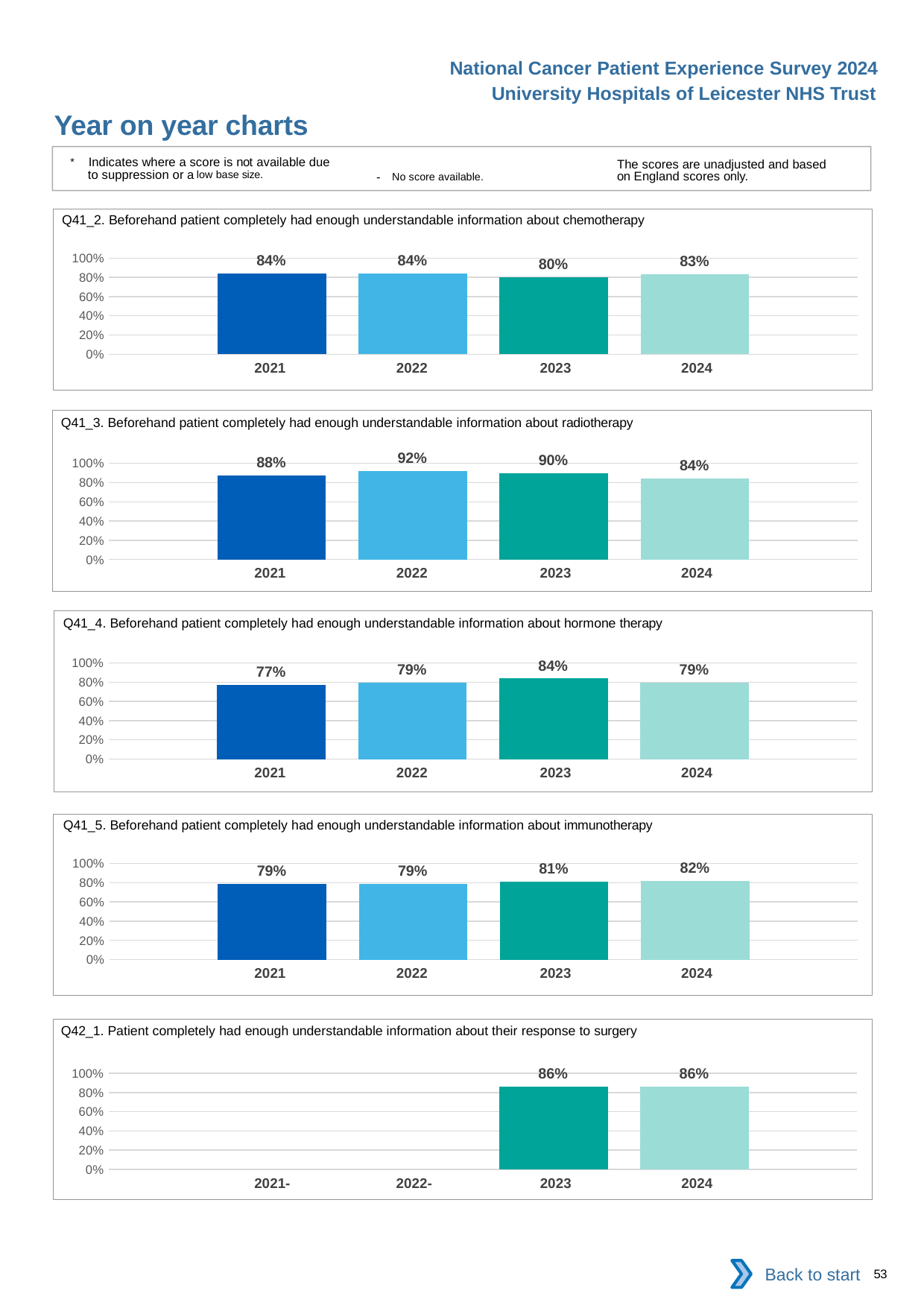
What kind of chart is the Q41_2 chart (chemotherapy)? bar chart In the Q41_4 chart (hormone therapy), which year has the lowest value? 2021 In the Q41_2 chart (chemotherapy), is the value for 2024 greater or less than 60%? greater In the Q42_1 chart (response to surgery), how many years have a bar plotted? 2 In the Q41_3 chart (radiotherapy), what is the difference between the 2022 and 2024 values? 8% In the Q41_4 chart (hormone therapy), what is the value for 2023? 84% In the Q41_5 chart (immunotherapy), is the value for 2023 or 2024 larger? 2024 In the Q42_1 chart (response to surgery), what is the value for 2024? 86% In the Q41_3 chart (radiotherapy), which year has the highest value? 2022 In the Q41_2 chart (chemotherapy), what is the value for 2023? 80% In the Q41_5 chart (immunotherapy), do the values rise or fall from 2022 to 2024? rise How many charts are shown on the slide? 5